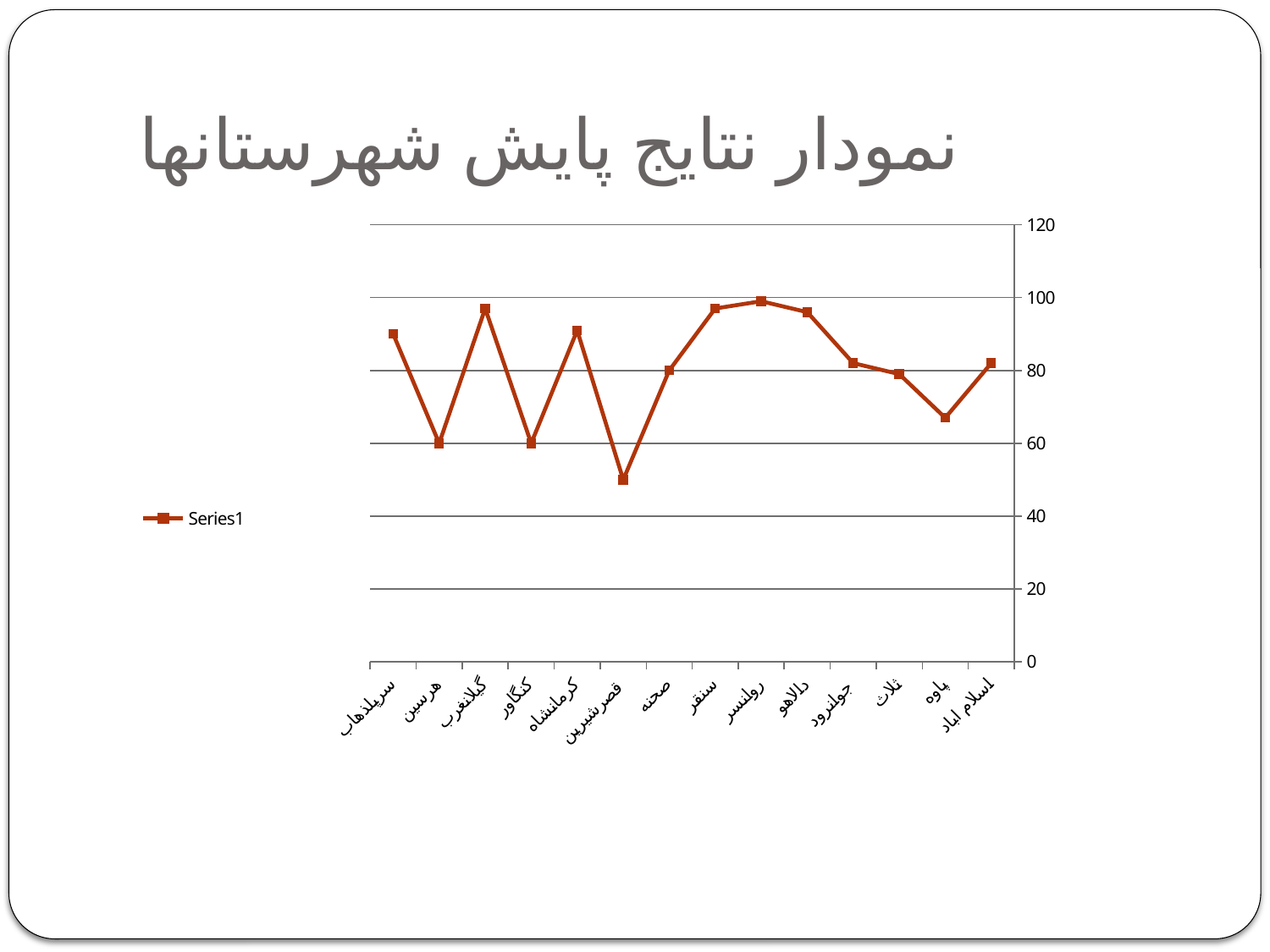
How many series does the chart legend list? 1 Is the value for گیلانغرب greater or less than 80? greater What is the name of the series shown in the chart legend? Series1 What kind of chart is shown on the slide? line chart Which has the larger value, جوانرود or پاوه? جوانرود Which category has the lowest value in the chart? قصرشیرین Is the value for روانسر greater or less than 80? greater Is the value for قصرشیرین greater or less than 60? less How many categories are plotted along the x axis of the chart? 14 Which has the larger value, روانسر or قصرشیرین? روانسر What is the title of the slide? نمودار نتایج پایش شهرستانها